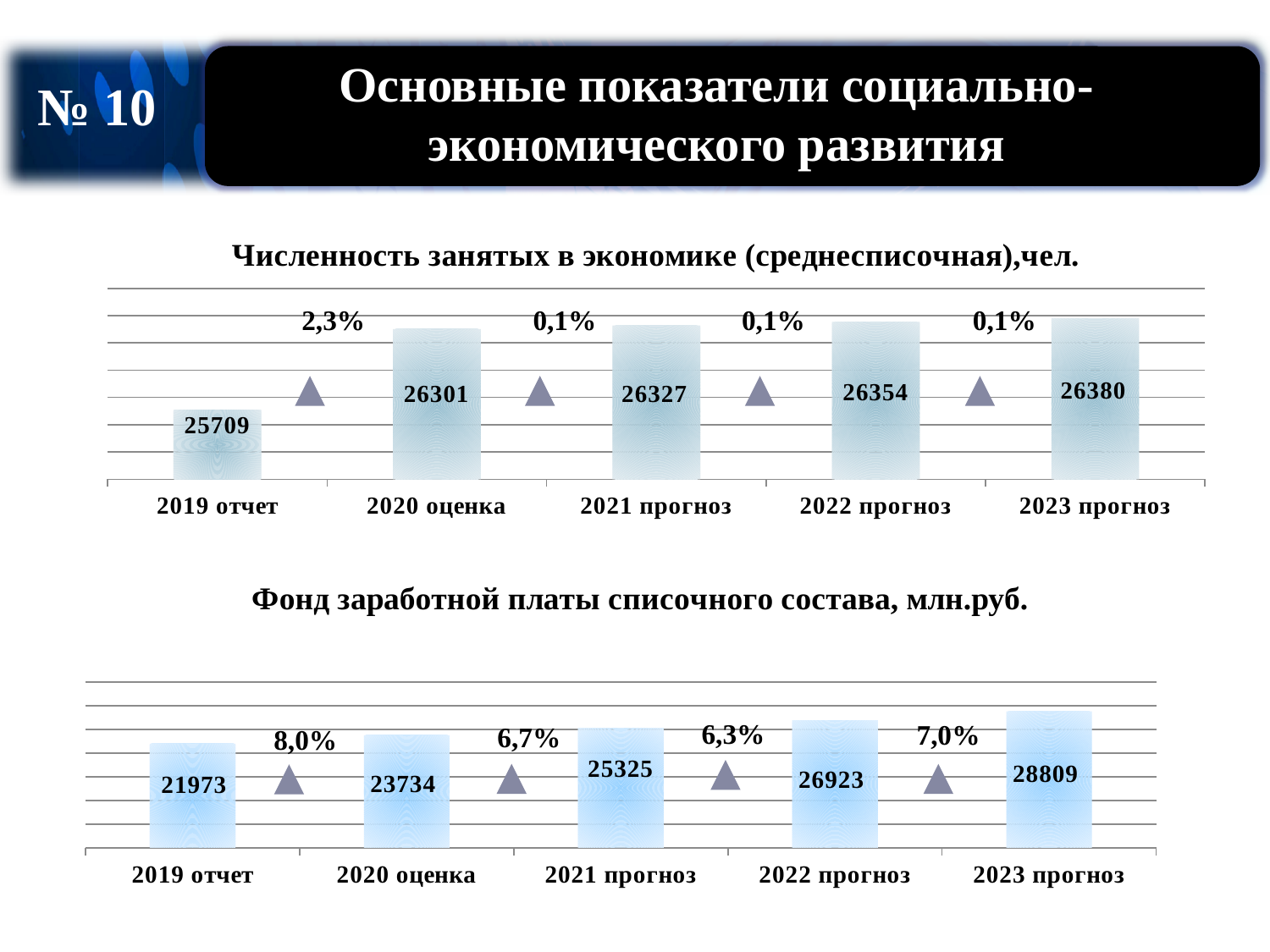
In the chart "Численность занятых в экономике (среднесписочная),чел.", what is the difference between the values for 2020 оценка and 2019 отчет? 592 In the chart "Фонд заработной платы списочного состава, млн.руб.", what is the value for 2021 прогноз? 25325 In the chart "Численность занятых в экономике (среднесписочная),чел.", what is the value for 2023 прогноз? 26380 In the chart "Численность занятых в экономике (среднесписочная),чел.", which category has the lowest value? 2019 отчет In the chart "Фонд заработной платы списочного состава, млн.руб.", do the values rise or fall from 2019 отчет to 2023 прогноз? rise In the chart "Численность занятых в экономике (среднесписочная),чел.", what growth percentage is shown between 2019 отчет and 2020 оценка? 2,3% In the chart "Фонд заработной платы списочного состава, млн.руб.", what is the difference between the values for 2023 прогноз and 2022 прогноз? 1886 In the chart "Численность занятых в экономике (среднесписочная),чел.", what is the value for 2019 отчет? 25709 In the chart "Фонд заработной платы списочного состава, млн.руб.", which is larger: the value for 2020 оценка or the value for 2022 прогноз? 2022 прогноз In the chart "Численность занятых в экономике (среднесписочная),чел.", how many categories are shown on the x axis? 5 What type of chart is the bottom chart on the slide? bar chart In the chart "Фонд заработной платы списочного состава, млн.руб.", which category has the highest value? 2023 прогноз